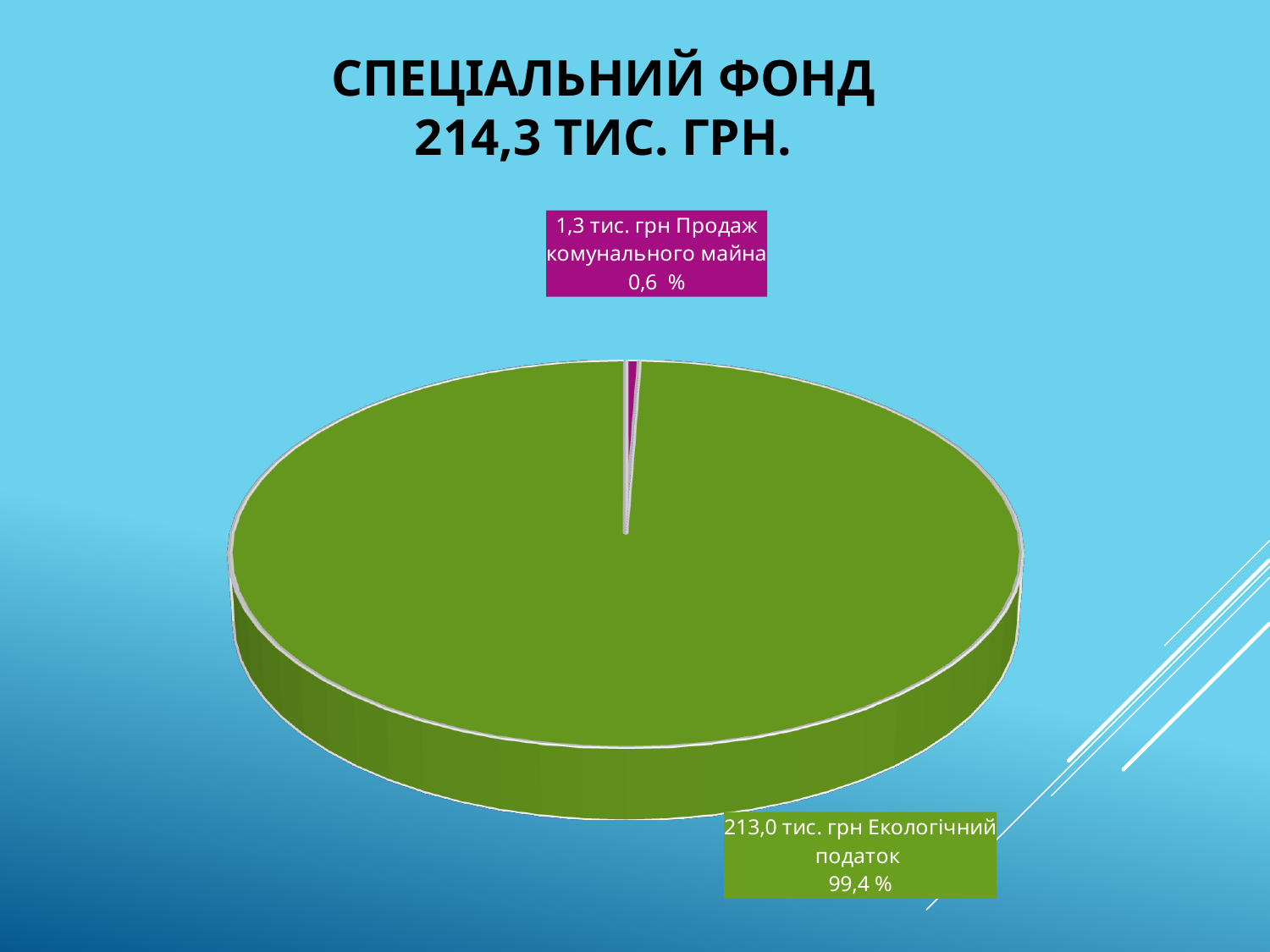
Which slice is the largest? Екологічний податок What share of the pie does Екологічний податок take? 99,4 % What is the value for Продаж комунального майна? 1,3 тис. грн What total amount is stated in the chart title? 214,3 тис. грн What is the difference in value between Екологічний податок and Продаж комунального майна? 211,7 тис. грн Which is larger, Екологічний податок or Продаж комунального майна? Екологічний податок What share of the pie does Продаж комунального майна take? 0,6 % How many slices does the pie chart have? 2 Which slice is the smallest? Продаж комунального майна What colour is the slice for Продаж комунального майна? magenta What kind of chart is shown on the slide? pie chart What is the value for Екологічний податок? 213,0 тис. грн